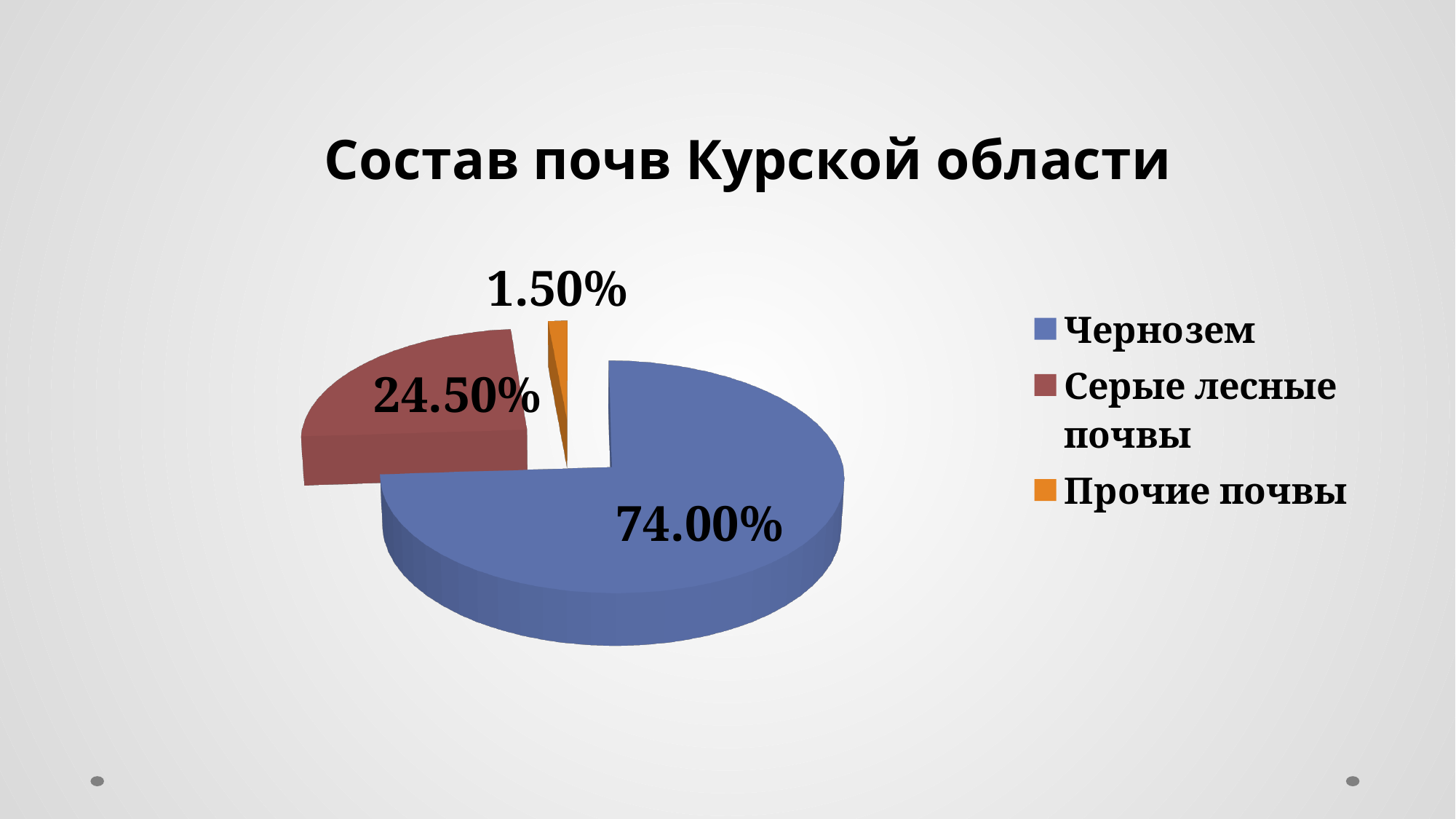
What is the difference between the shares of Чернозем and Серые лесные почвы? 49.50% What is the difference between the shares of Серые лесные почвы and Прочие почвы? 23.00% What share of the pie does Серые лесные почвы have? 24.50% What kind of chart is shown on the slide? Pie chart How many categories are shown in the pie chart? 3 What colour is the slice for Прочие почвы? Orange Which category has the smallest slice of the pie? Прочие почвы Which category has the largest slice of the pie? Чернозем Which is larger, the share of Серые лесные почвы or the share of Прочие почвы? Серые лесные почвы What is the title of the chart? Состав почв Курской области What share of the pie does Прочие почвы have? 1.50% What share of the pie does Чернозем have? 74.00%